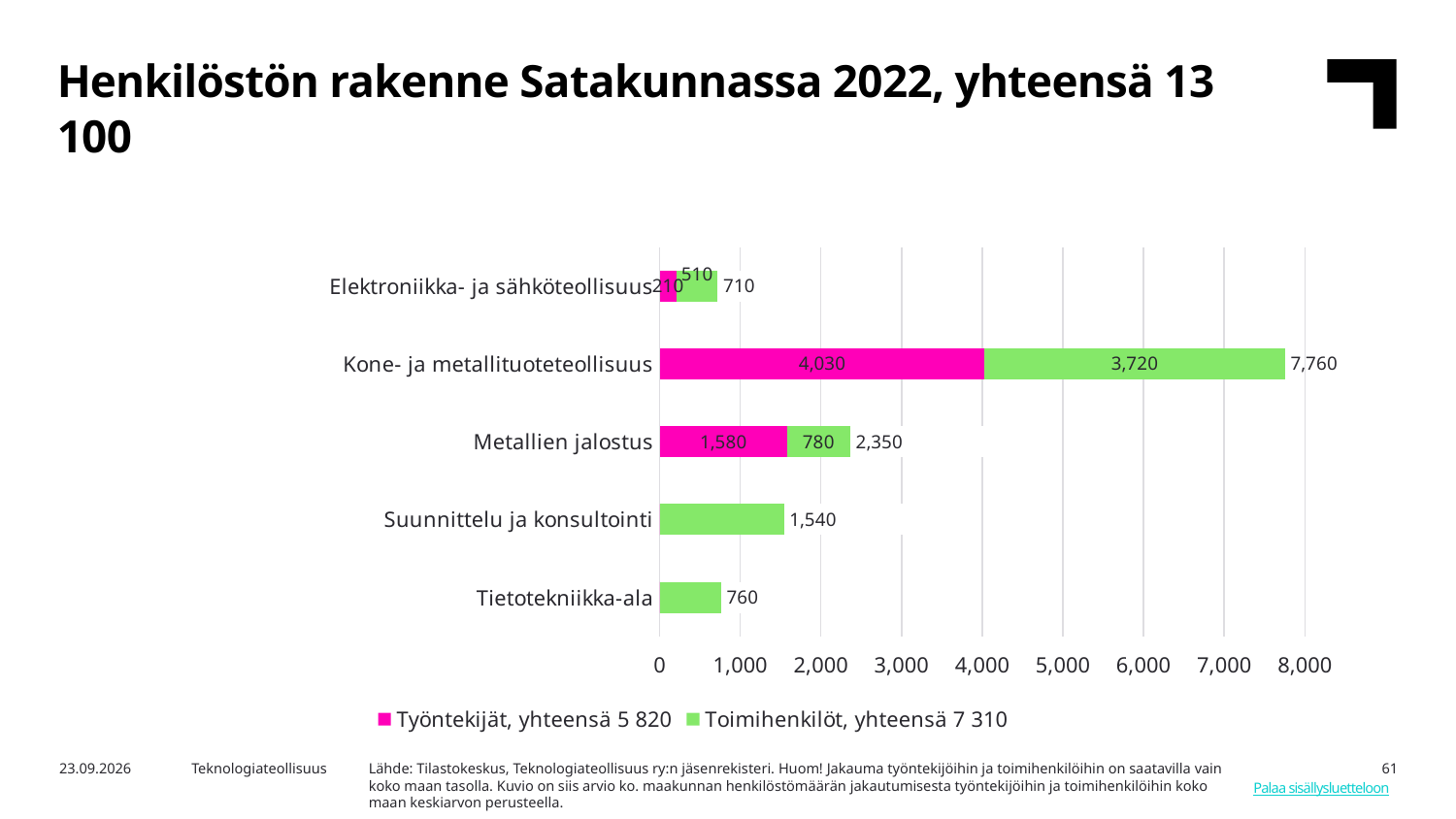
What is the total for the Kone- ja metallituoteteollisuus bar? 7,760 What is the difference between the Työntekijät and Toimihenkilöt values for Metallien jalostus? 800 What is the total for Työntekijät given in the legend? 5 820 What type of chart is shown on the slide? Stacked bar chart What is the total for the Elektroniikka- ja sähköteollisuus bar? 710 Which category has the lowest total? Elektroniikka- ja sähköteollisuus Which is larger: the total for Suunnittelu ja konsultointi or the total for Tietotekniikka-ala? Suunnittelu ja konsultointi Which category has the highest total? Kone- ja metallituoteteollisuus What is the Toimihenkilöt value for Metallien jalostus? 780 What is the Työntekijät value for Kone- ja metallituoteteollisuus? 4,030 How many series does the legend list? 2 How many categories are shown on the chart? 5